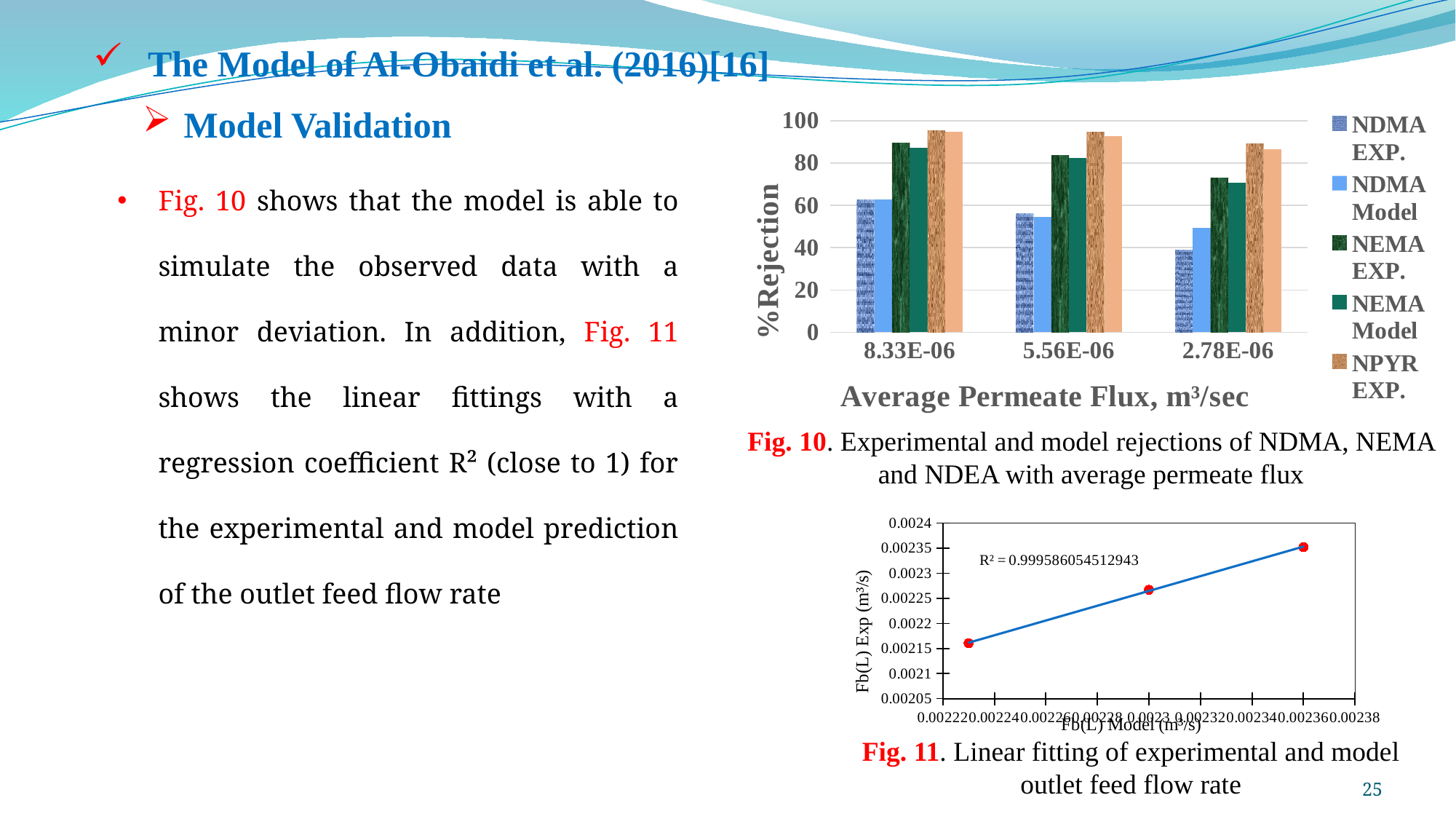
In Fig. 10, at 5.56E-06, which is larger: NEMA EXP. or NDMA EXP.? NEMA EXP. In Fig. 11, what R² value is printed on the chart? R² = 0.999586054512943 What kind of chart is Fig. 10? bar chart In Fig. 11, do the plotted values rise or fall as Fb(L) Model increases along the x axis? rise In Fig. 10, is the NDMA EXP. value at 8.33E-06 greater or less than 40? greater In Fig. 10, is the NDMA Model value at 2.78E-06 greater or less than 60? less In Fig. 10, is the NEMA EXP. value at 8.33E-06 greater or less than 80? greater What is the y-axis label of Fig. 10? %Rejection In Fig. 10, which series has the lowest bar at 2.78E-06? NDMA EXP. In Fig. 10, does the NDMA EXP. rejection rise or fall moving from 8.33E-06 to 2.78E-06 along the x axis? fall In Fig. 10, how many average permeate flux categories are shown on the x axis? 3 In Fig. 11, how many data points are plotted? 3